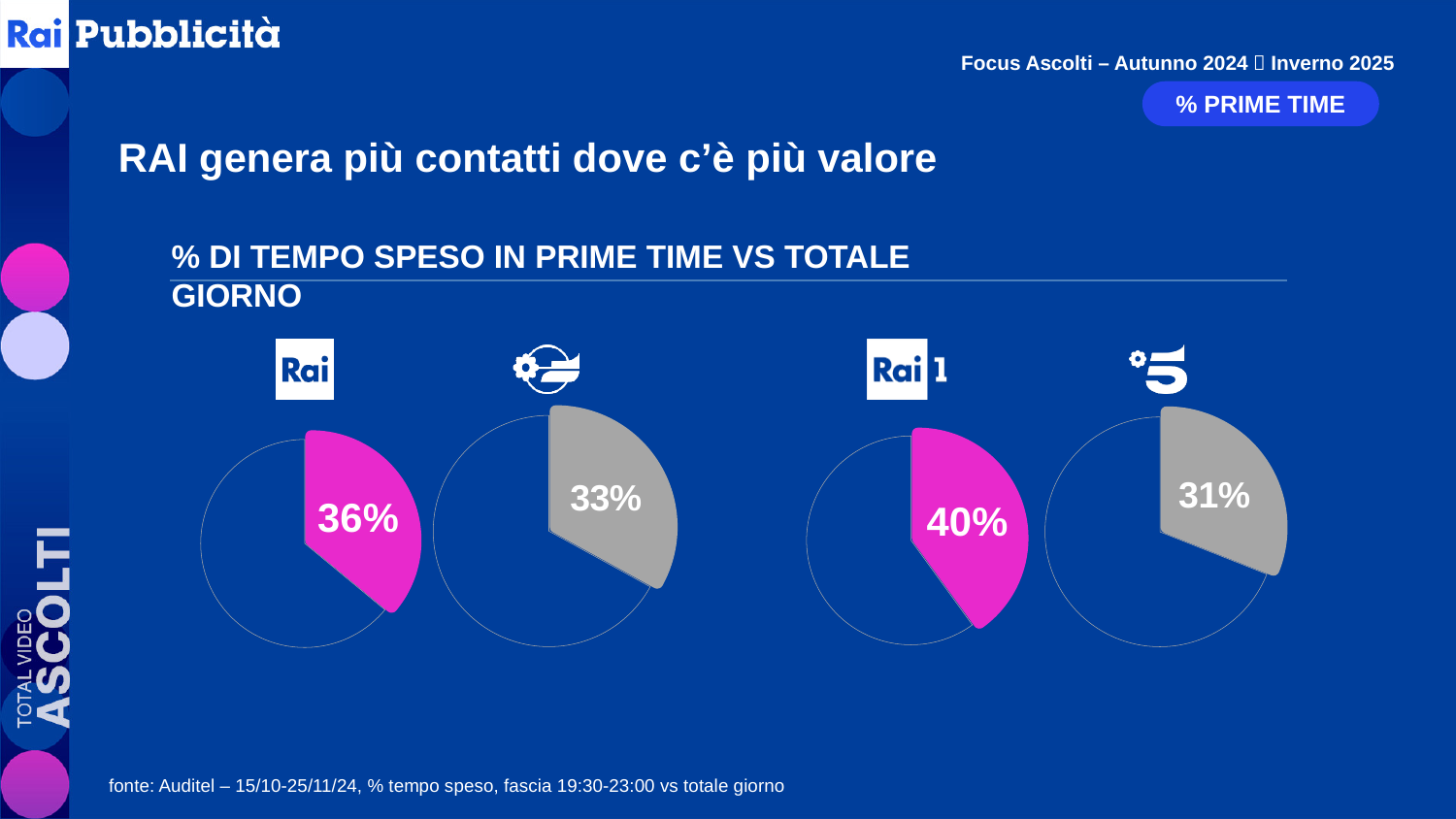
How many pie charts are shown on the slide? 4 Which of the four pie charts shows the highest percentage? Rai 1 (40%) What kind of chart is used to show the percentages on this slide? Pie chart What colour are the slices in the pie charts for Rai and Rai 1? Magenta/pink What percentage is shown in the second pie chart from the left (grey slice)? 33% Which of the four pie charts shows the lowest percentage? The rightmost pie (31%) What percentage is shown in the pie chart labelled Rai 1 (third pie from the left)? 40% What percentage is shown in the pie chart labelled Rai (leftmost pie)? 36% What is the difference between the percentage for Rai 1 and the percentage in the rightmost pie chart? 9 percentage points Which is larger: the percentage for Rai or the percentage in the second pie chart from the left? Rai (36%) What percentage is shown in the rightmost pie chart (grey slice)? 31% What is the difference between the percentage for Rai and the percentage in the second pie chart from the left? 3 percentage points